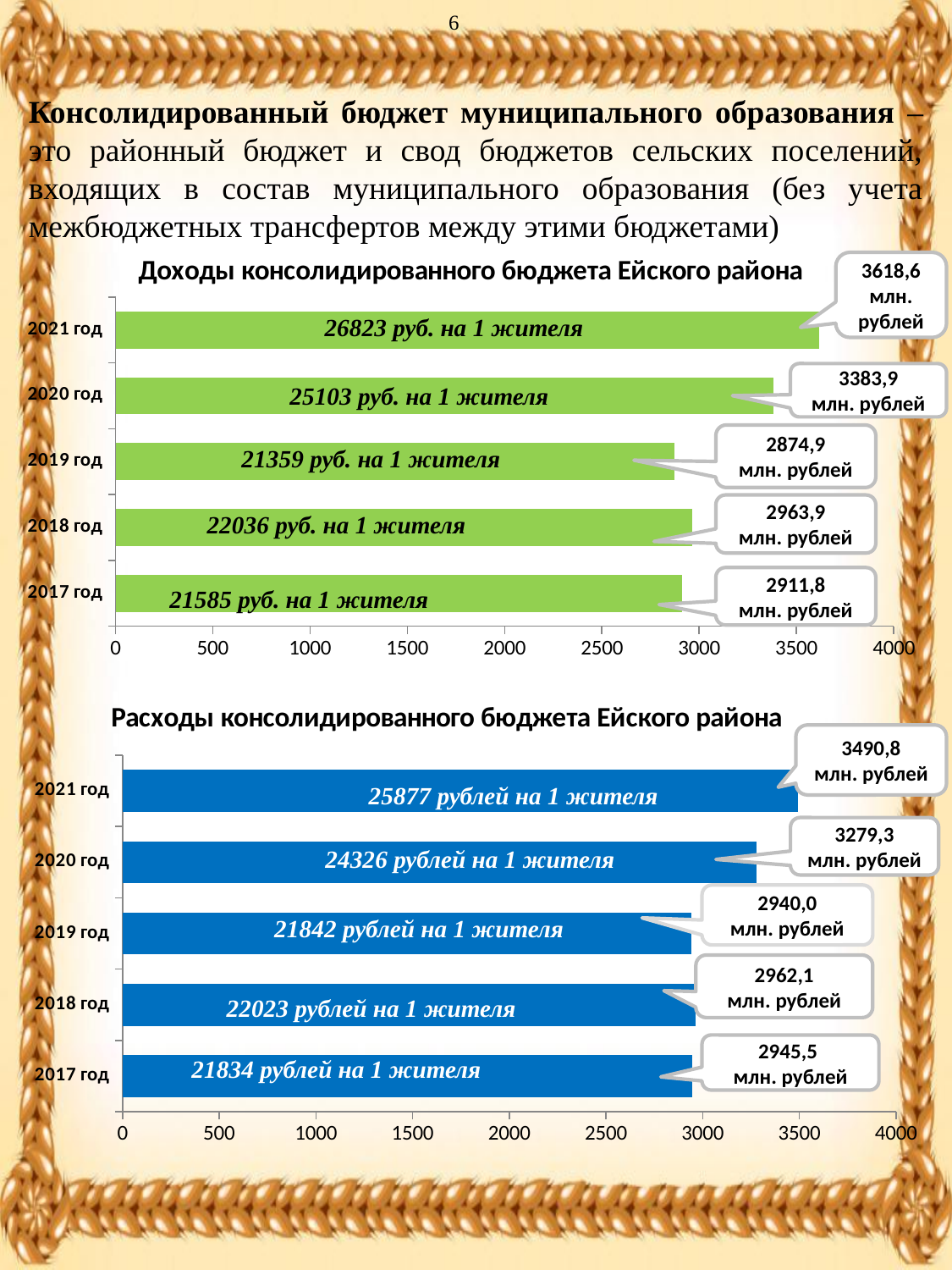
On the 'Доходы консолидированного бюджета Ейского района' chart, what is the difference between the values for 2021 год and 2020 год? 234,7 млн. рублей On the 'Доходы консолидированного бюджета Ейского района' chart, is the value for 2020 год greater or less than 3000? greater How many years are shown on the 'Расходы консолидированного бюджета Ейского района' chart? 5 On the 'Расходы консолидированного бюджета Ейского района' chart, which is larger: the value for 2018 год or 2019 год? 2018 год On the 'Расходы консолидированного бюджета Ейского района' chart, which year has the highest value? 2021 год On the 'Расходы консолидированного бюджета Ейского района' chart, what is the value for 2020 год? 3279,3 млн. рублей What type of chart is the 'Доходы консолидированного бюджета Ейского района' chart? bar chart On the 'Доходы консолидированного бюджета Ейского района' chart, which year has the highest value? 2021 год On the 'Доходы консолидированного бюджета Ейского района' chart, what is the value for 2021 год? 3618,6 млн. рублей On the 'Доходы консолидированного бюджета Ейского района' chart, what is the value for 2019 год? 2874,9 млн. рублей On the 'Расходы консолидированного бюджета Ейского района' chart, what is the per-resident amount shown on the bar for 2017 год? 21834 рублей на 1 жителя On the 'Доходы консолидированного бюджета Ейского района' chart, which year has the lowest value? 2019 год